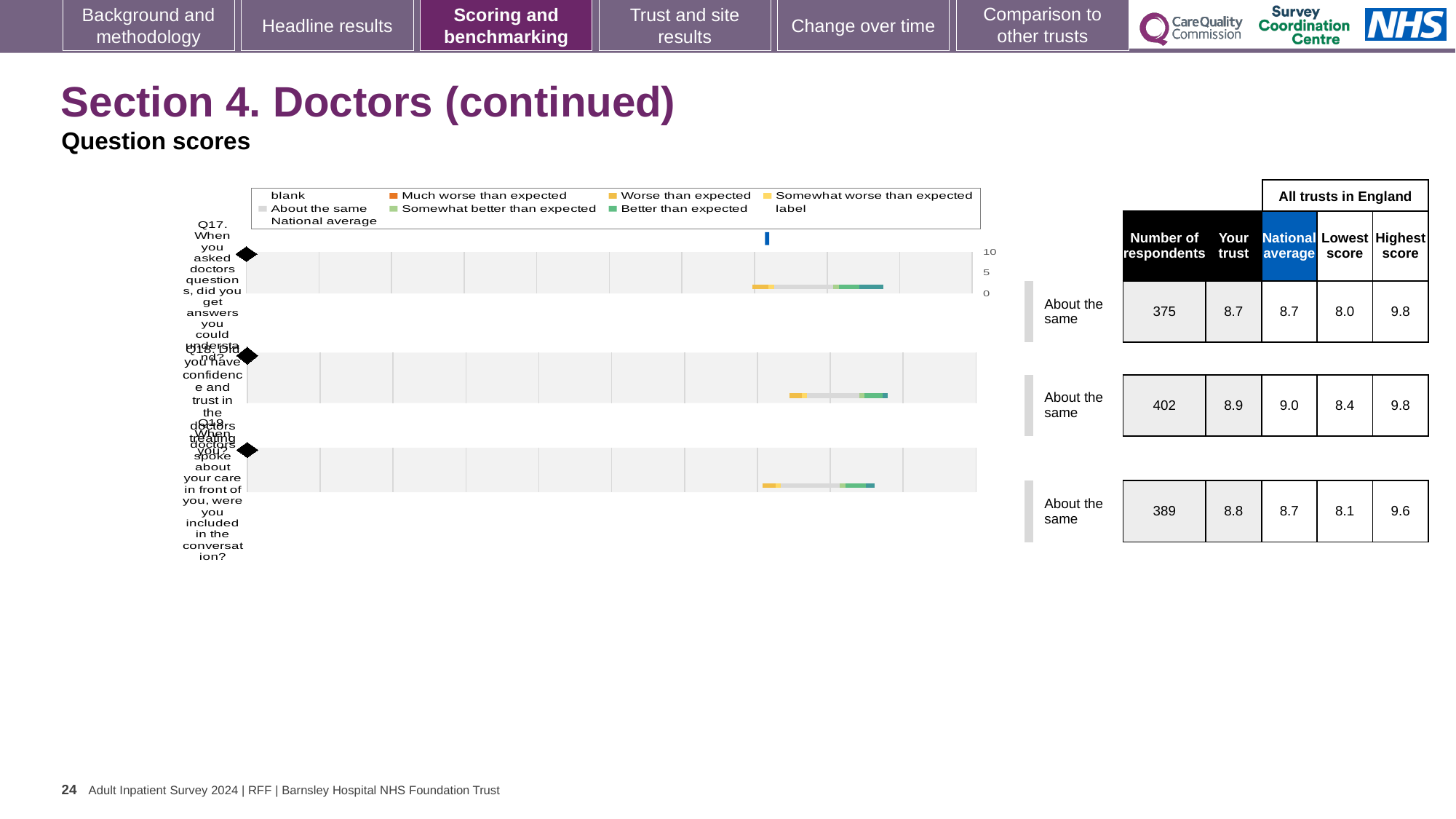
What is the national average score for Q19 (When doctors spoke about your care in front of you, were you included in the conversation?)? 8.7 What kind of chart is used to show the question scores on this slide? bar chart What is the 'Your trust' score for Q17 (When you asked doctors questions, did you get answers you could understand?)? 8.7 How many questions (Q17, Q18, Q19) are plotted in the charts on this slide? 3 What is the highest value shown on the chart axis? 10 How many entries does the chart legend list? 9 Which benchmark category is assigned to Q17, Q18 and Q19 on this slide? About the same What is the 'Your trust' score for Q18 (Did you have confidence and trust in the doctors treating you?)? 8.9 What is the difference between the highest score and the lowest score across all trusts in England for Q18? 1.4 Which legend entry is shown in orange in the chart legend? Much worse than expected Is the 'Your trust' score for Q17 greater or less than 5 on the chart axis? greater Which question has the highest 'Your trust' score: Q17, Q18 or Q19? Q18